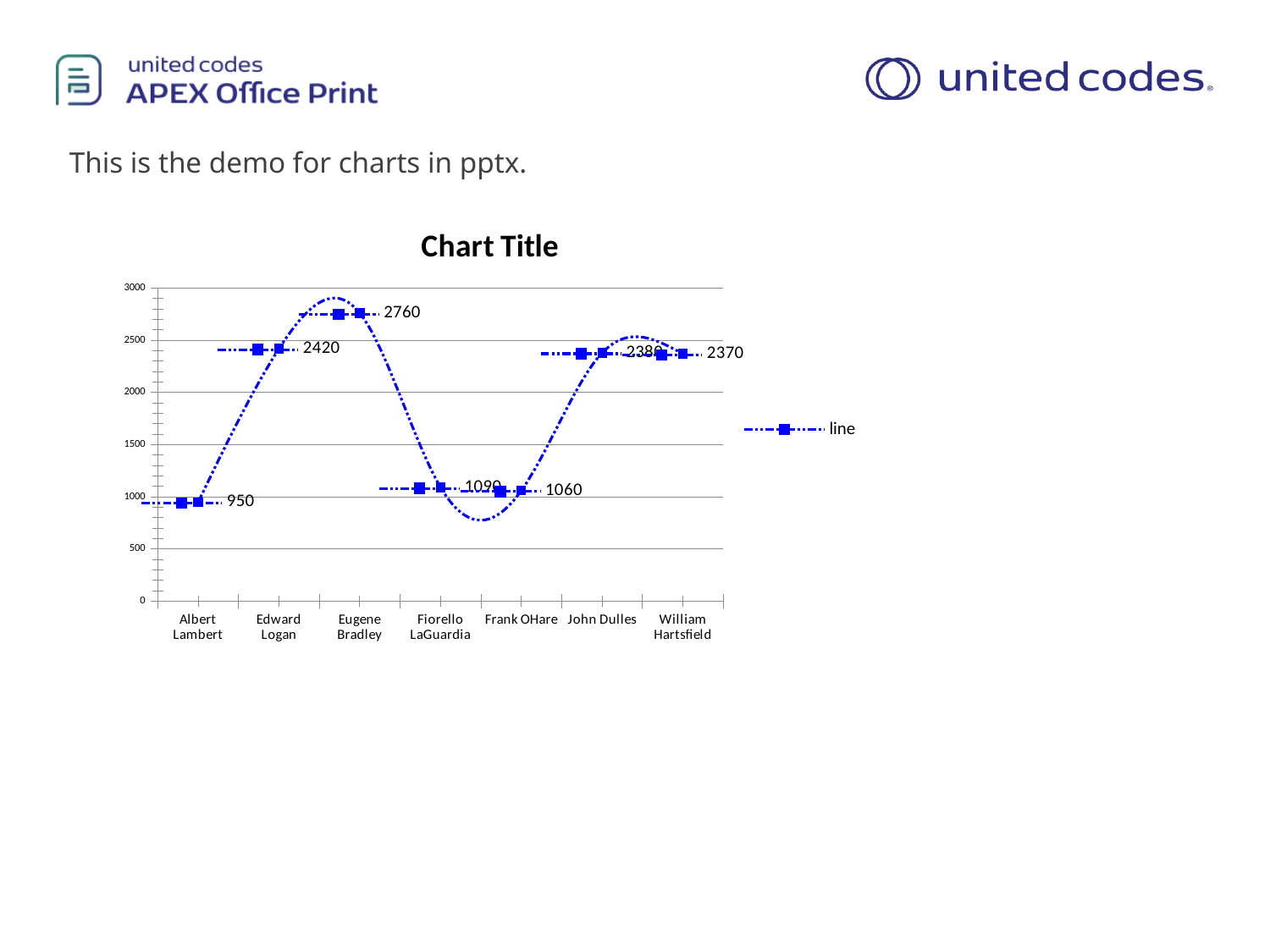
What is the value for Albert Lambert? 950 Which is larger, the value for Edward Logan or the value for Fiorello LaGuardia? Edward Logan How many series does the legend list? 1 Which category has the lowest value? Albert Lambert How many categories are shown on the x axis? 7 What is the value for Frank OHare? 1060 What kind of chart is shown on the slide? line chart What is the value for William Hartsfield? 2370 Which category has the highest value? Eugene Bradley What is the difference between the values for Eugene Bradley and Edward Logan? 340 What is the value for Eugene Bradley? 2760 What is the value for Edward Logan? 2420